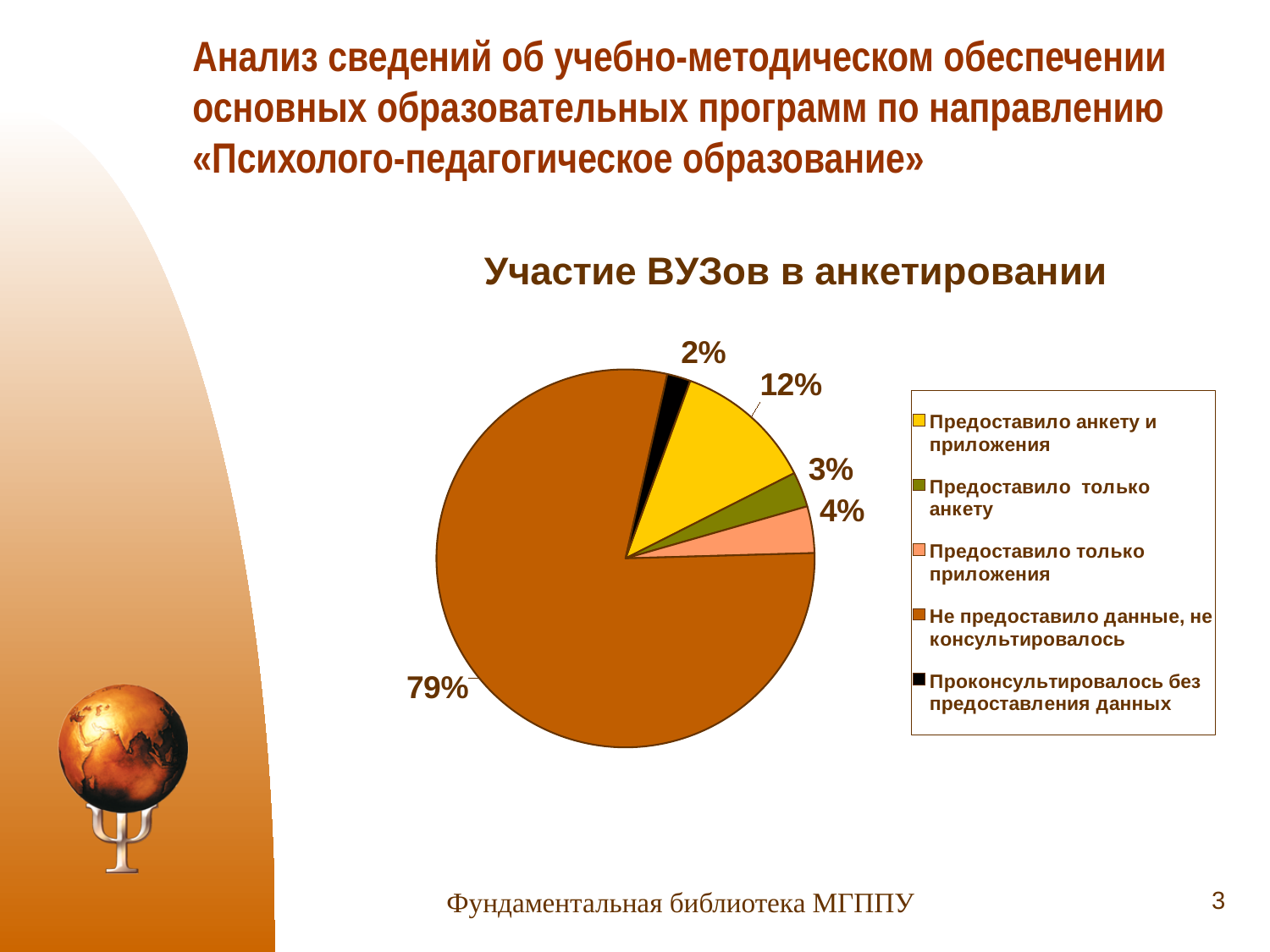
How many entries does the legend list? 5 What share of the pie is 'Не предоставило данные, не консультировалось'? 79% What is the difference between the share for 'Предоставило анкету и приложения' and the share for 'Предоставило только приложения'? 8% What share of the pie is 'Предоставило только приложения'? 4% Which category has the largest slice of the pie? Не предоставило данные, не консультировалось What share of the pie is 'Проконсультировалось без предоставления данных'? 2% What kind of chart is shown on the slide? pie chart Which category has the smallest slice of the pie? Проконсультировалось без предоставления данных What is the title of the chart? Участие ВУЗов в анкетировании How many slices does the pie chart have? 5